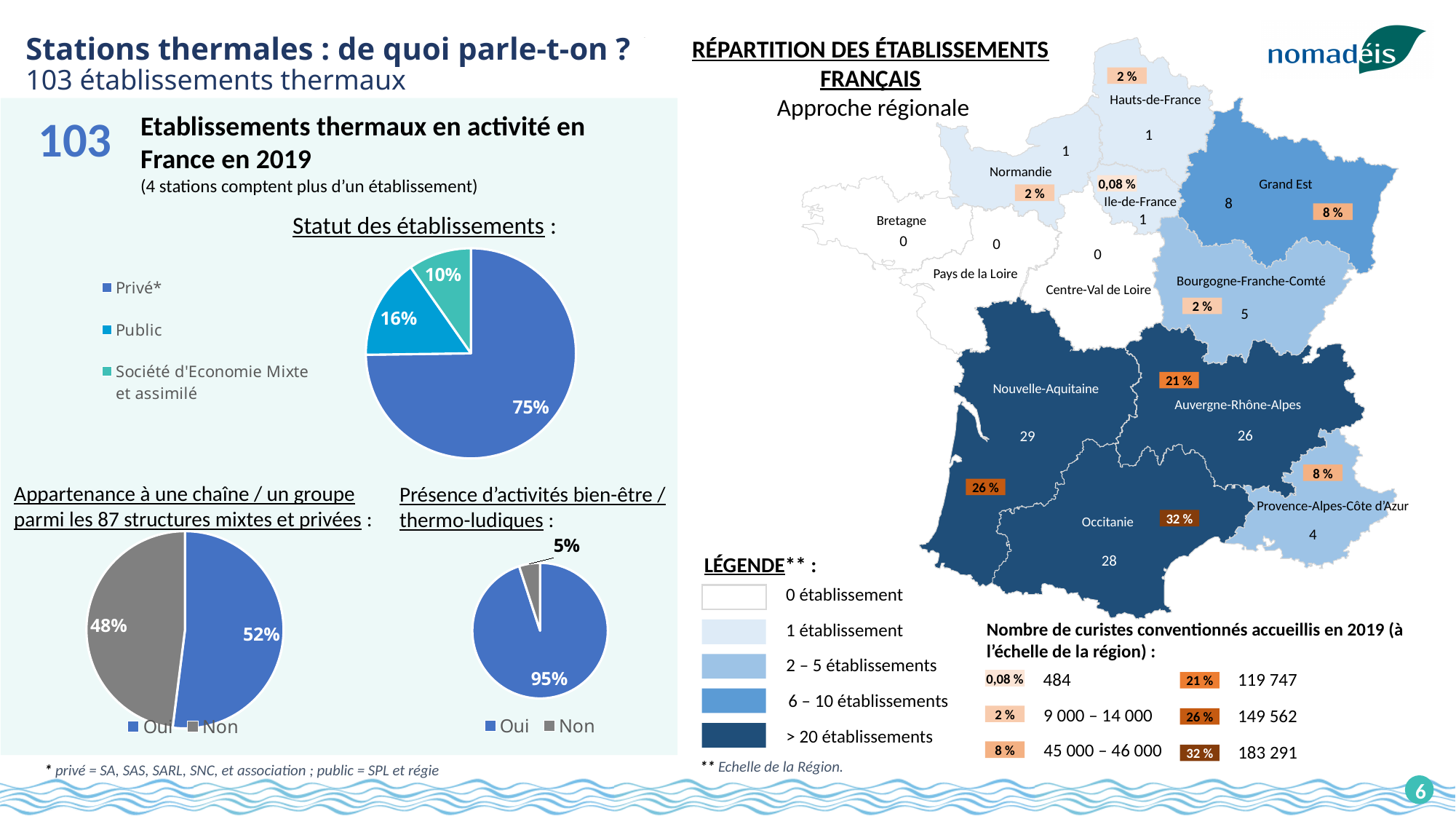
How many slices does the 'Statut des établissements' pie chart have? 3 In the 'Statut des établissements' pie chart, what share is Privé*? 75% On the map 'Répartition des établissements français', which region has the highest number of establishments? Nouvelle-Aquitaine In the 'Appartenance à une chaîne / un groupe' pie chart, which is larger, Oui or Non? Oui On the map 'Répartition des établissements français', how many establishments are in Occitanie? 28 In the 'Statut des établissements' pie chart, which category has the smallest share? Société d'Economie Mixte et assimilé What type of chart is used for 'Statut des établissements'? Pie chart In the 'Présence d'activités bien-être / thermo-ludiques' pie chart, how many percentage points larger is Oui than Non? 90 In the 'Appartenance à une chaîne / un groupe' pie chart, what share is Oui? 52% In the 'Statut des établissements' pie chart, what share is Public? 16% In the 'Présence d'activités bien-être / thermo-ludiques' pie chart, what share is Non? 5% In the 'Statut des établissements' pie chart, how many percentage points larger is Public than Société d'Economie Mixte et assimilé? 6